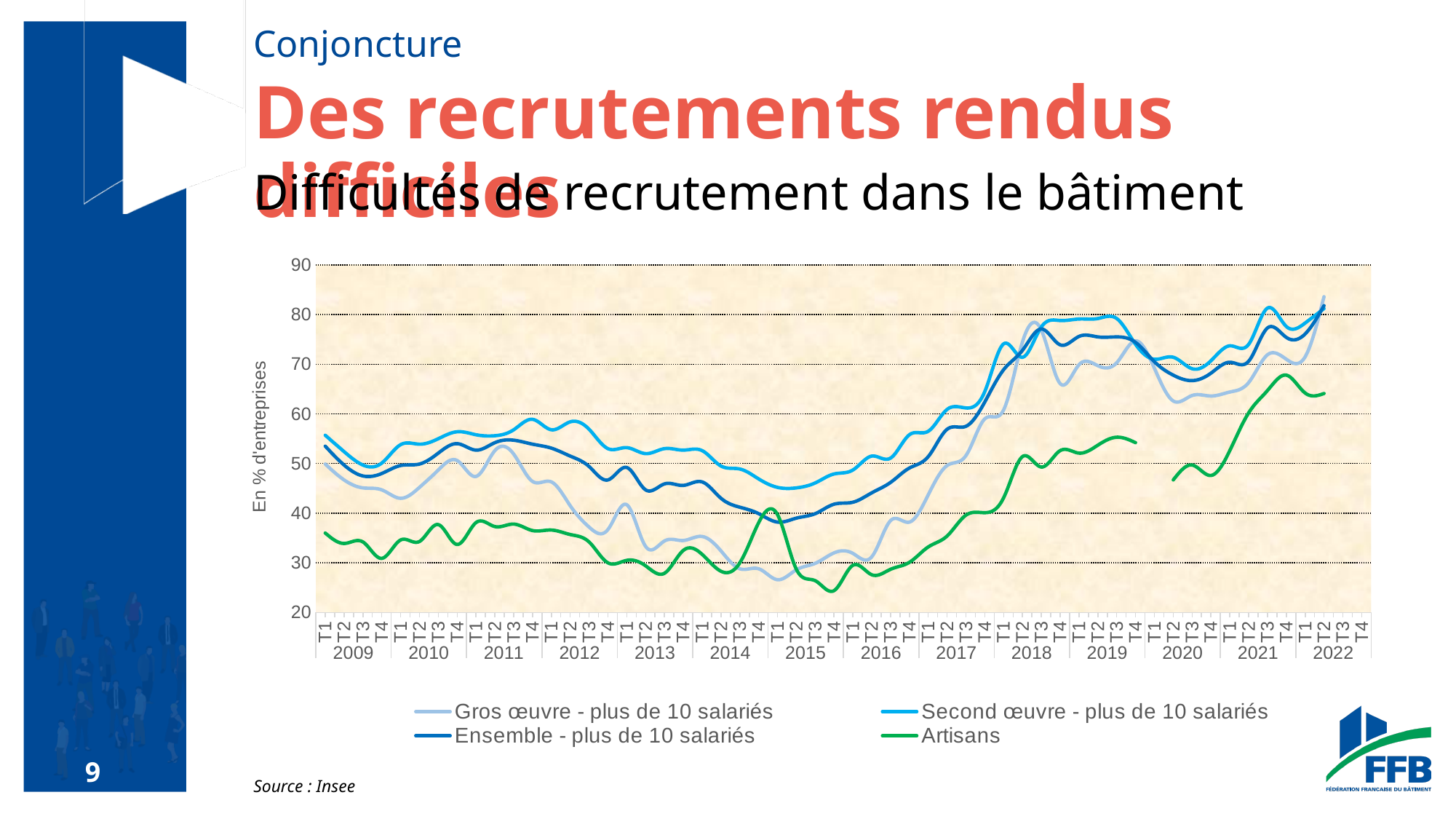
What is the label of the vertical axis? En % d'entreprises Is the value for Gros œuvre - plus de 10 salariés in T1 2015 greater or less than 30? less Is the value for Artisans in T4 2021 greater or less than 60? greater In T4 2021, which is higher: Second œuvre - plus de 10 salariés or Artisans? Second œuvre - plus de 10 salariés Does the Second œuvre - plus de 10 salariés series rise or fall between 2012 and 2015? fall What kind of chart is shown on the slide? line chart What is the title of the chart? Difficultés de recrutement dans le bâtiment How many series does the legend list? 4 Is the value for Artisans in T4 2015 greater or less than 30? less How many years are labelled along the x axis? 14 Does the Artisans series rise or fall between 2016 and 2018? rise